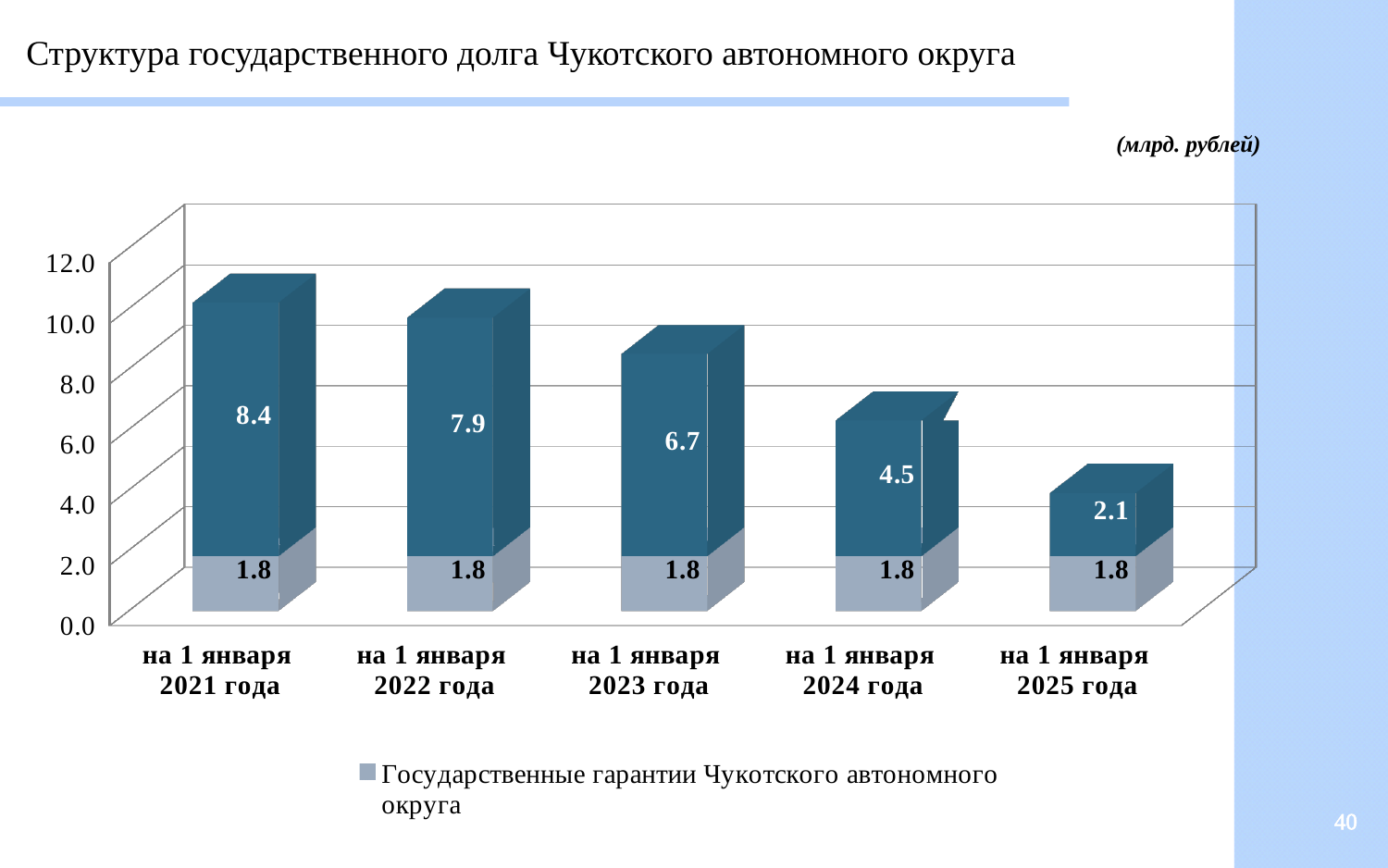
What is the value of the Государственные гарантии Чукотского автономного округа segment for на 1 января 2023 года? 1.8 What is the total of the stacked bar for на 1 января 2025 года? 3.9 What is the difference between the dark blue segment values for на 1 января 2022 года and на 1 января 2023 года? 1.2 How many dates (categories) are shown along the x axis? 5 Do the dark blue (upper) segment values rise or fall from 2021 to 2025 along the x axis? fall What is the total of the stacked bar for на 1 января 2021 года? 10.2 What is the value of the dark blue (upper) segment for на 1 января 2024 года? 4.5 What is the value of the dark blue (upper) segment for на 1 января 2021 года? 8.4 In what units are the values on the chart given, according to the note above the chart? млрд. рублей For which date is the dark blue (upper) segment the smallest? на 1 января 2025 года What type of chart is shown on the slide? bar chart For which date is the dark blue (upper) segment the largest? на 1 января 2021 года